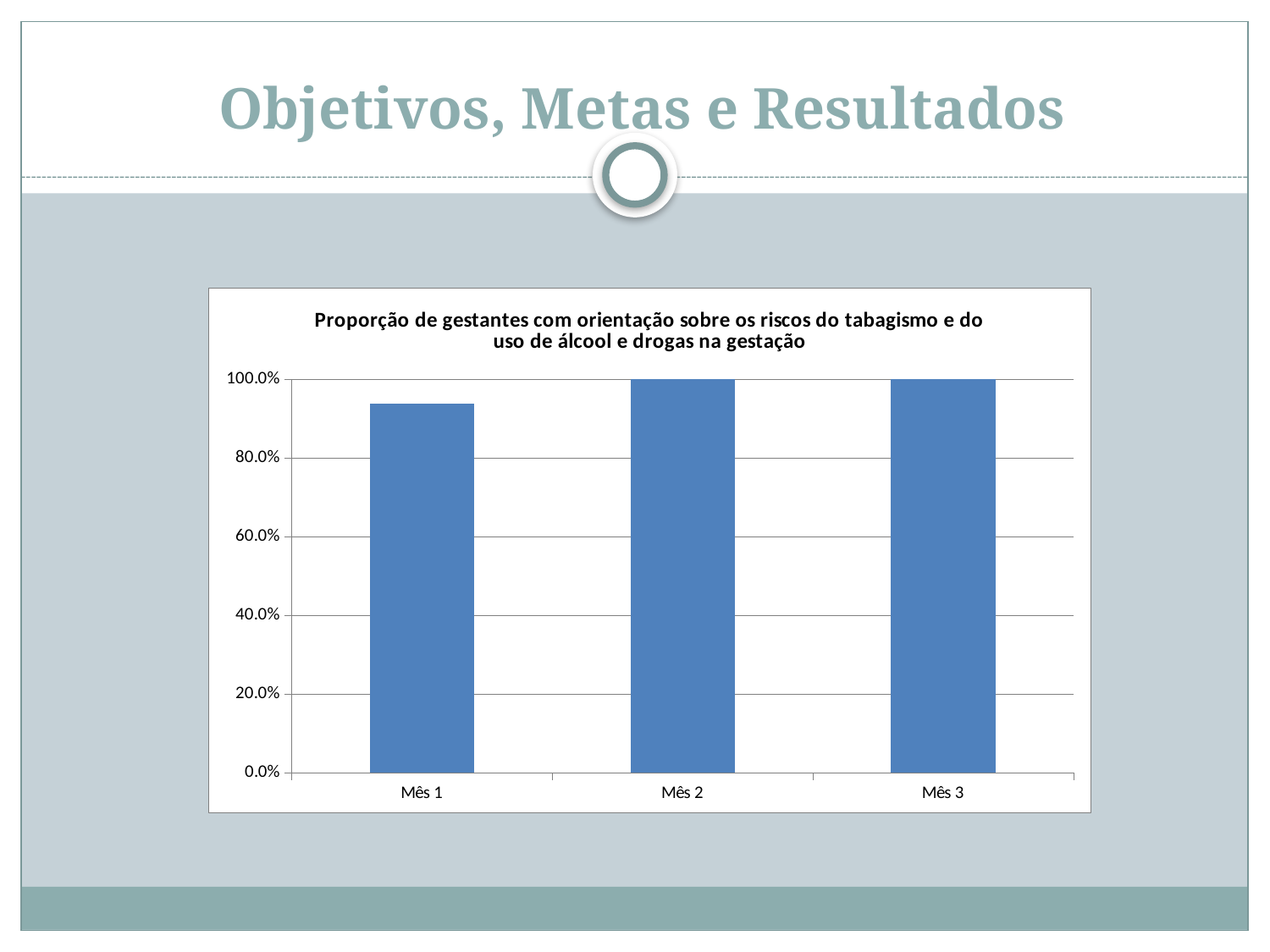
What is the value for Mês 2? 100.0% Is the value for Mês 1 greater or less than 100.0%? less Which category has the lowest value? Mês 1 Do the values rise or fall from Mês 1 to Mês 2? rise What is the highest value shown on the y axis of the chart? 100.0% What is the title of the chart? Proporção de gestantes com orientação sobre os riscos do tabagismo e do uso de álcool e drogas na gestação What kind of chart is shown on the slide? bar chart Which is larger, the value for Mês 1 or the value for Mês 2? Mês 2 What is the difference between the values for Mês 2 and Mês 3? 0.0% Is the value for Mês 1 greater or less than 80.0%? greater What is the value for Mês 3? 100.0% How many categories are shown on the x axis of the chart? 3